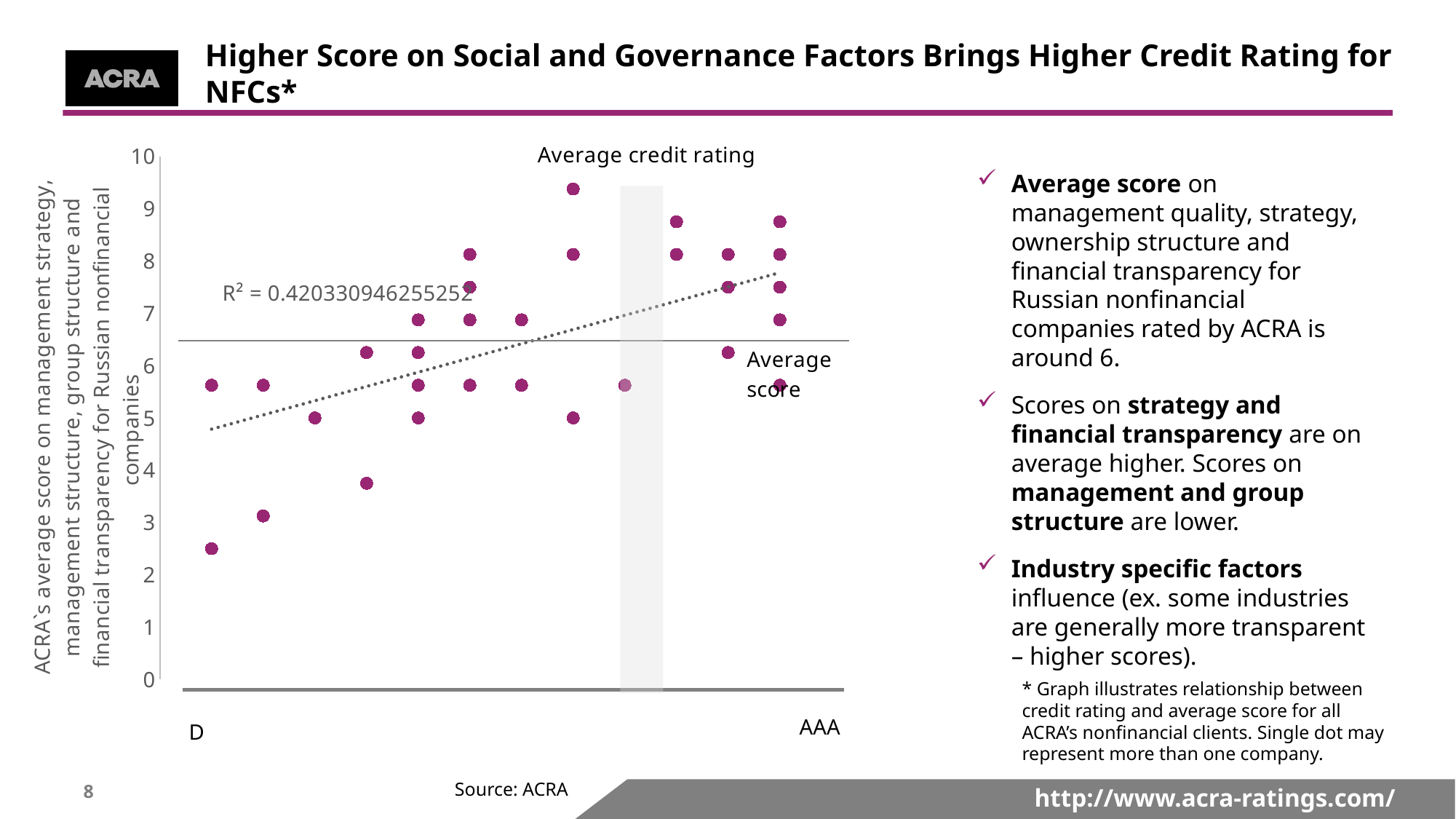
What is the maximum value shown on the vertical axis of the chart? 10 Is the lowest plotted point greater or less than 2? greater What are the two labels shown at the ends of the horizontal axis? D and AAA What kind of chart is shown on the slide? Scatter chart What R² value is printed on the chart? R² = 0.420330946255252 Is the highest plotted point on the chart greater or less than 9? greater Is the lowest plotted point on the chart greater or less than 3? less Does the dotted trend line rise or fall as the credit rating moves from D toward AAA? Rises